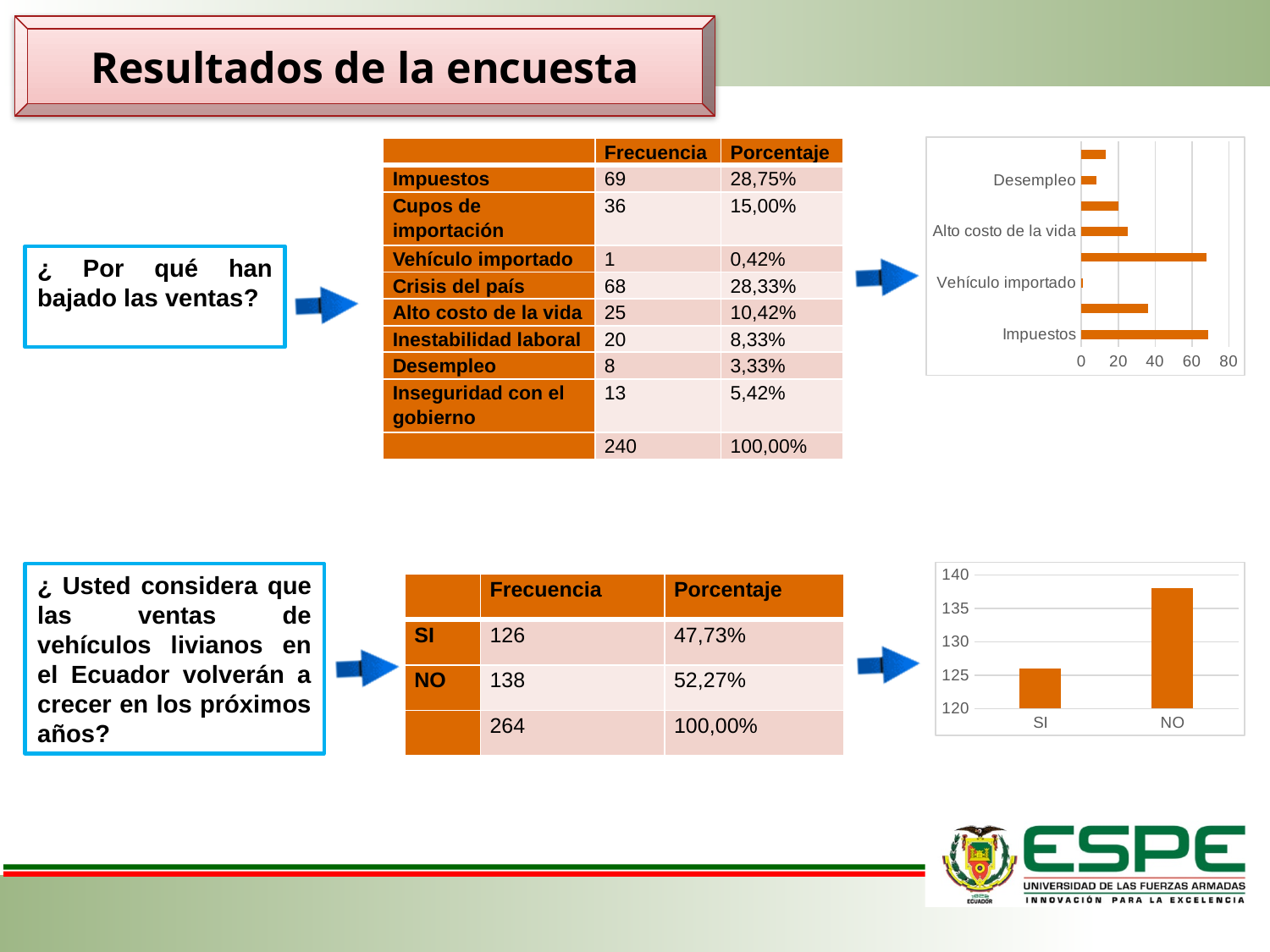
In the top-right bar chart, which of the labelled categories has the shortest bar? Vehículo importado In the bottom-right bar chart, which category has the taller bar, SI or NO? NO In the top-right bar chart, which of the labelled categories has the longest bar? Impuestos In the bottom-right bar chart, is the value for SI greater or less than 130? less How many bars are plotted in the top-right bar chart? 8 In the top-right bar chart, is the value for Alto costo de la vida greater or less than 20? greater In the top-right bar chart, which is larger, Alto costo de la vida or Desempleo? Alto costo de la vida In the top-right bar chart, is the value for Vehículo importado greater or less than 20? less What kind of chart is the top-right chart on the slide? bar chart